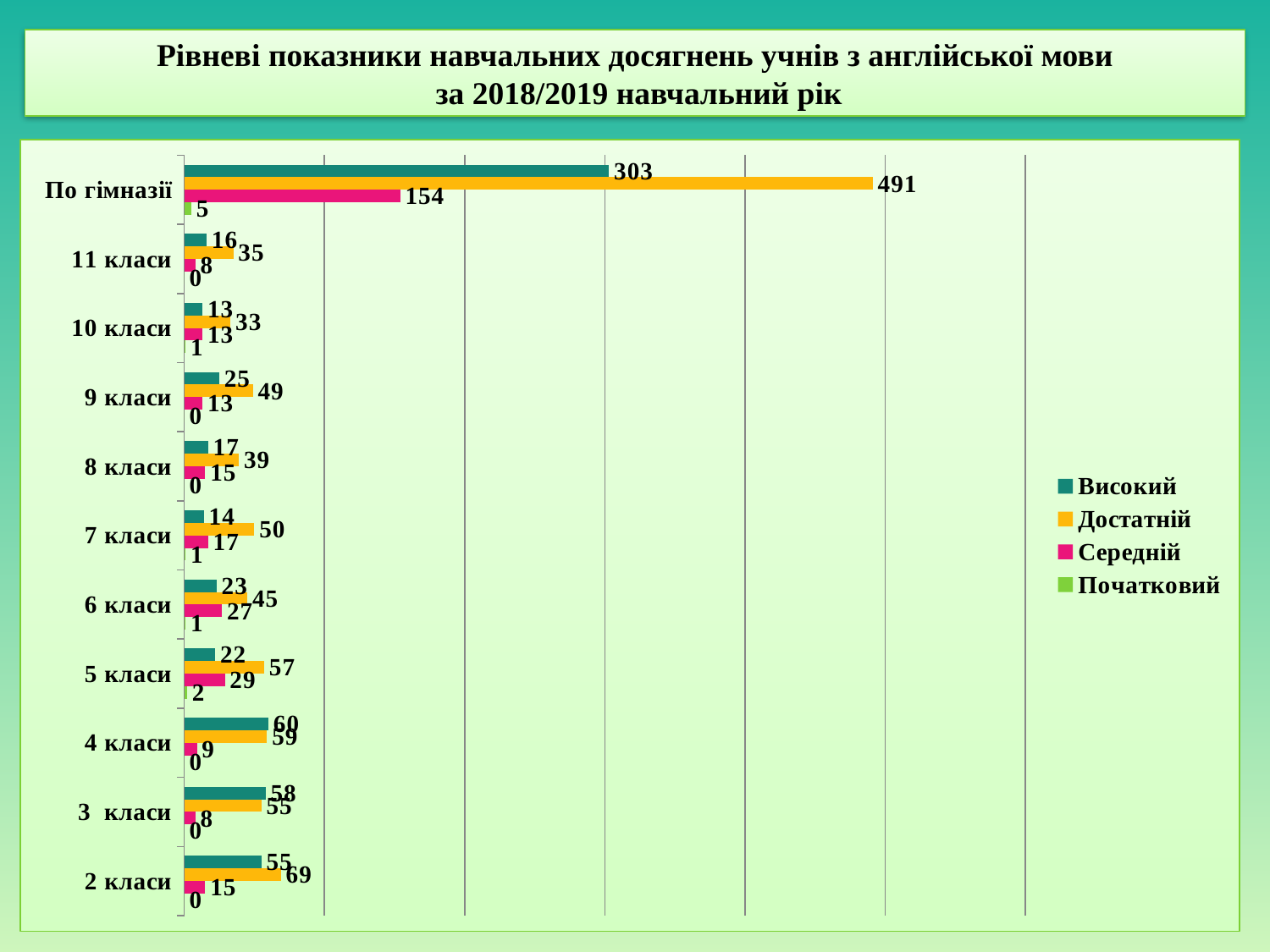
What is the difference between the Достатній and Високий values for По гімназії? 188 Which is larger for 6 класи: the Високий value or the Середній value? Середній What kind of chart is shown on the slide? bar chart What is the value of Достатній for По гімназії? 491 Which series is shown in pink in the legend? Середній How many categories are shown on the vertical axis? 11 What is the value of Середній for 5 класи? 29 Among the class categories (excluding По гімназії), which has the lowest Високий value? 10 класи What is the value of Високий for 4 класи? 60 Among the class categories (excluding По гімназії), which has the highest Достатній value? 2 класи What is the value of Початковий for 10 класи? 1 How many series does the legend list? 4